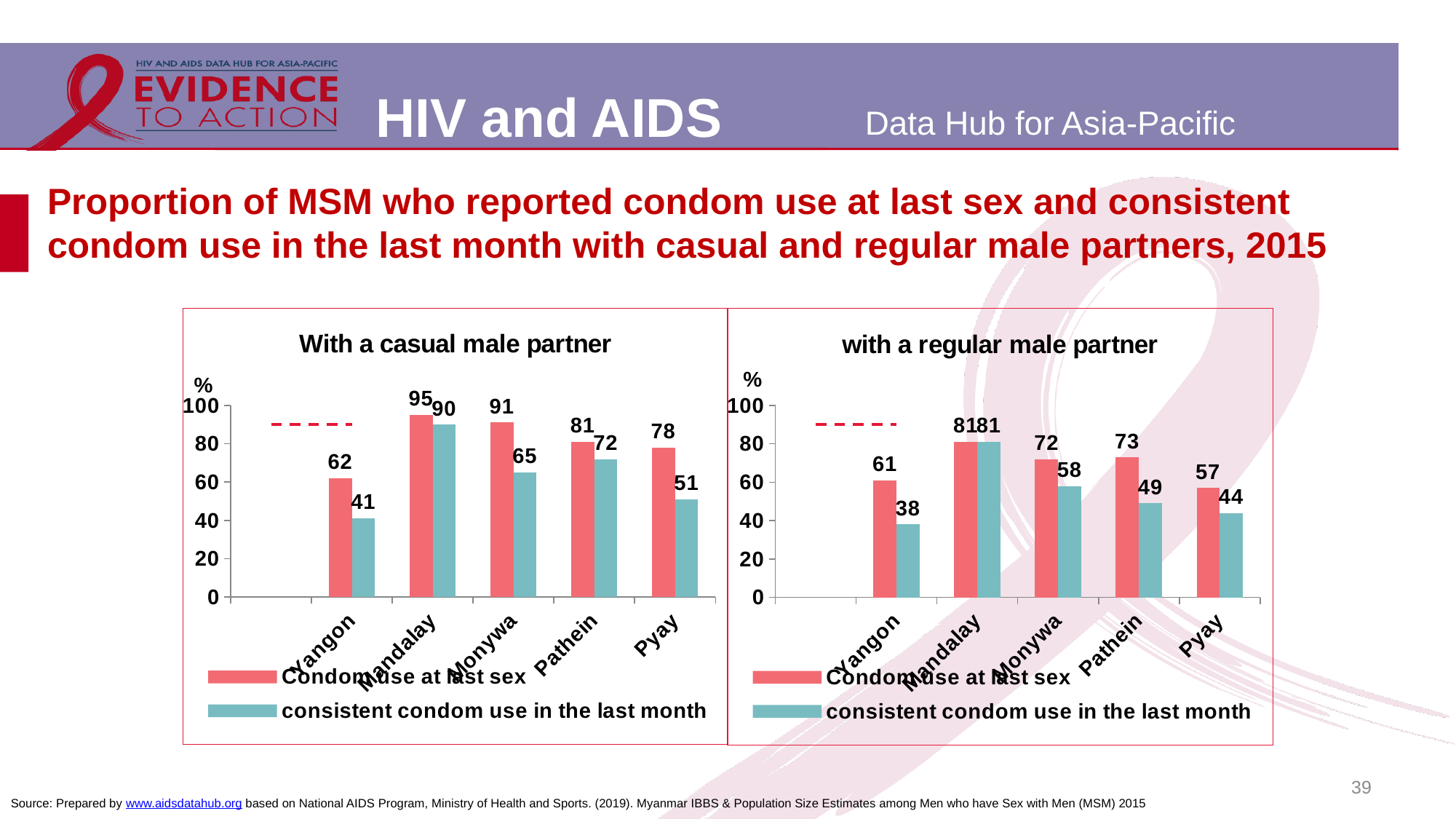
How many series does the legend of the 'With a casual male partner' chart list? 2 In the 'with a regular male partner' chart, what is the value for consistent condom use in the last month in Yangon? 38 In the 'With a casual male partner' chart, what is the value for condom use at last sex in Mandalay? 95 In the 'with a regular male partner' chart, what is the value for condom use at last sex in Pyay? 57 What type of chart is the 'with a regular male partner' chart? Bar chart In the 'with a regular male partner' chart, which city has the highest value for condom use at last sex? Mandalay How many cities are shown on the x axis of the 'with a regular male partner' chart? 5 In the 'with a regular male partner' chart, which is larger for Pathein: condom use at last sex or consistent condom use in the last month? Condom use at last sex In the 'With a casual male partner' chart, is the value for consistent condom use in the last month in Monywa greater or less than 60? greater In the 'With a casual male partner' chart, which city has the lowest value for consistent condom use in the last month? Yangon What is the title of the left chart on the slide? With a casual male partner In the 'With a casual male partner' chart, what is the difference between condom use at last sex and consistent condom use in the last month for Pyay? 27